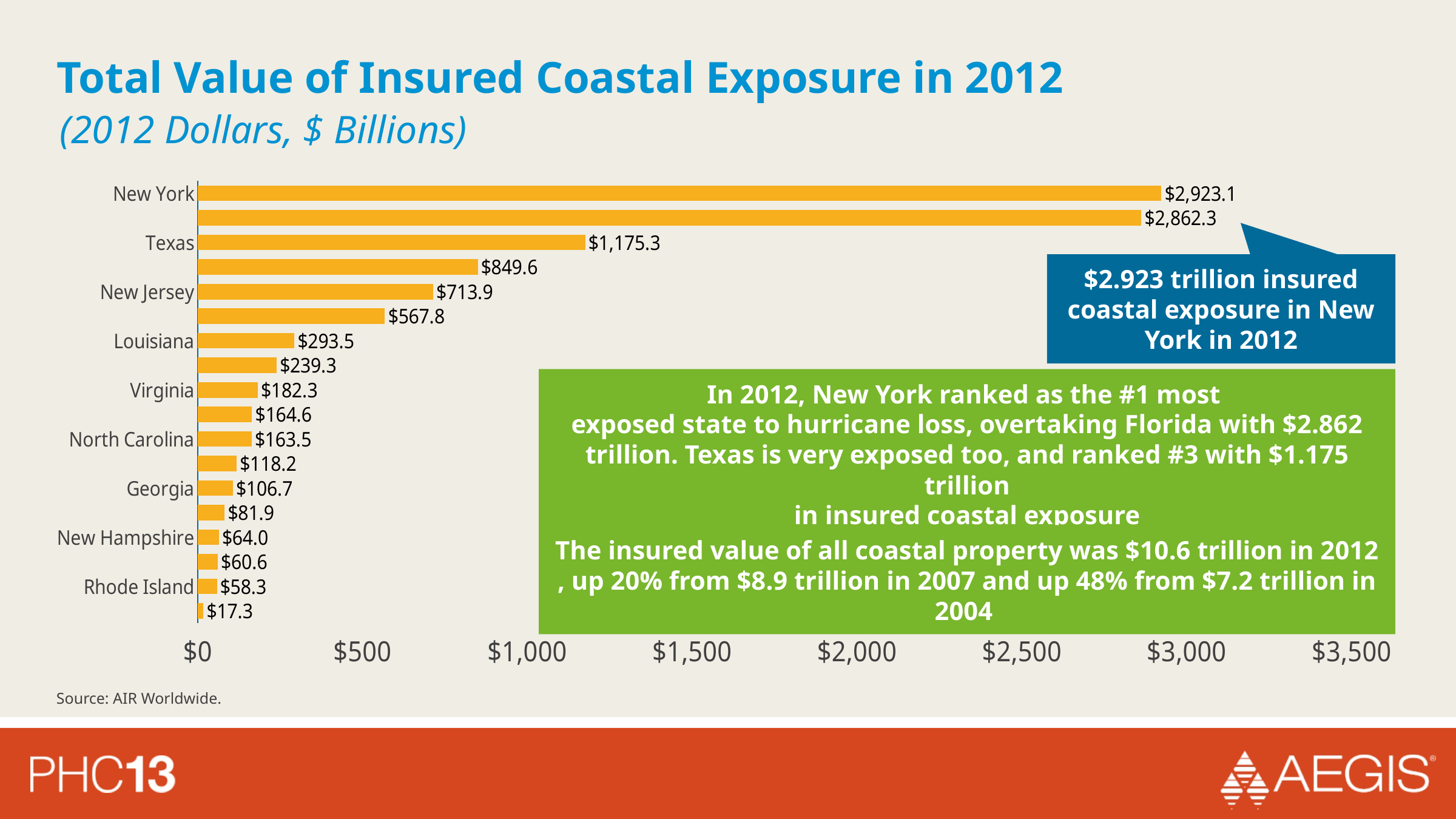
What is the value for Louisiana? $293.5 What kind of chart is shown on the slide? bar chart Which state has the highest insured coastal exposure? New York What is the value for New York? $2,923.1 What is the value for New Jersey? $713.9 What is the value for Rhode Island? $58.3 What is the difference between the values for New York and Texas? $1,747.8 What is the value for Texas? $1,175.3 Is the value for Texas greater or less than $1,000? greater Which is larger, the value for Virginia or the value for Georgia? Virginia How many bars are plotted on the chart? 18 What is the value of the shortest bar on the chart? $17.3